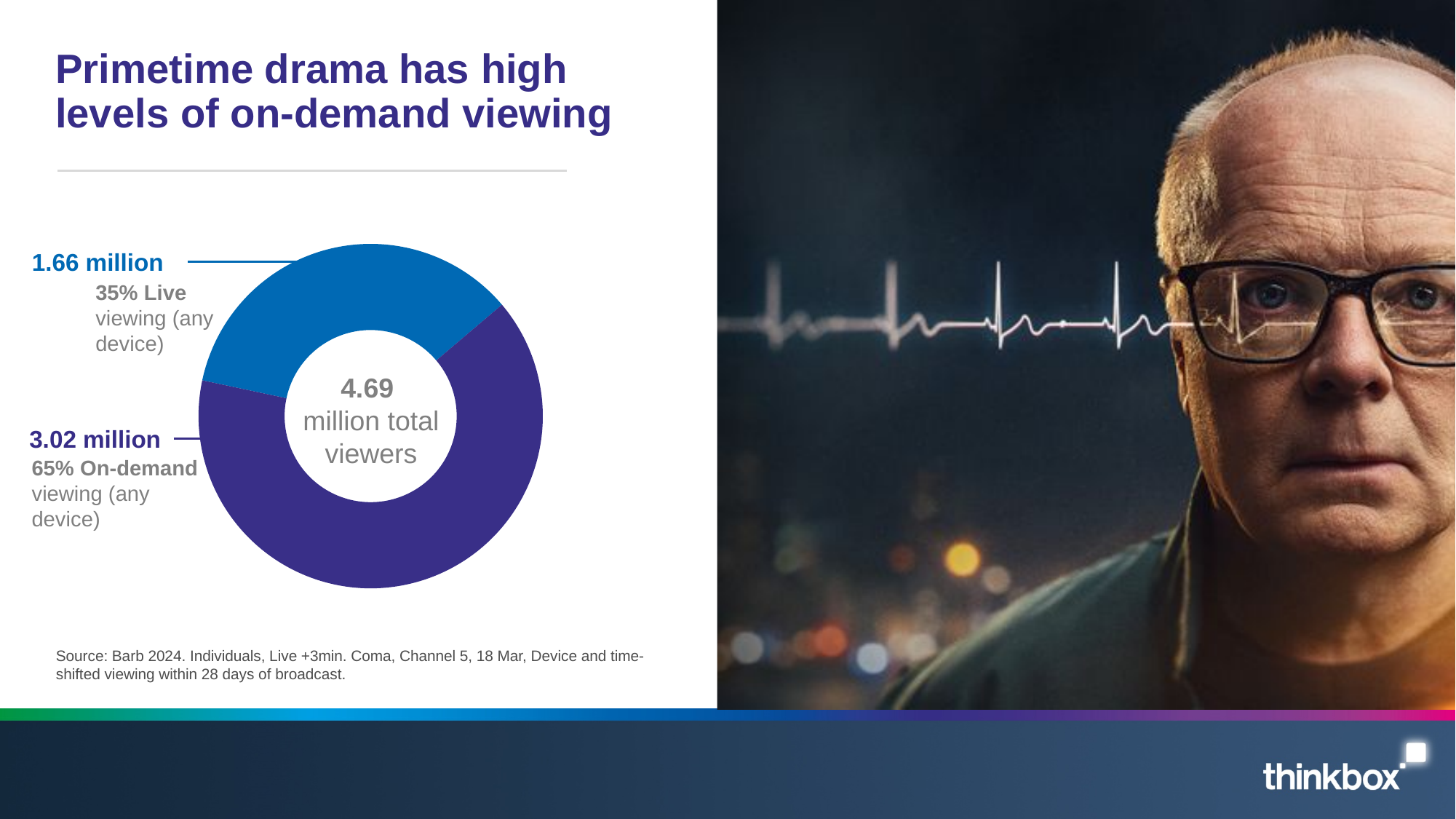
What share of total viewers is Live viewing (any device)? 35% What is the title of the slide? Primetime drama has high levels of on-demand viewing What share of total viewers is On-demand viewing (any device)? 65% How many viewers does the On-demand viewing (any device) segment represent? 3.02 million What colour is the On-demand viewing segment? Purple What is the total number of viewers shown in the centre of the chart? 4.69 million How many segments does the chart have? 2 What is the difference in viewers between On-demand viewing and Live viewing? 1.36 million Which segment is larger, Live viewing or On-demand viewing? On-demand viewing What kind of chart is shown on the slide? Doughnut (pie) chart Which segment has the smallest share of viewers? Live viewing (any device) How many viewers does the Live viewing (any device) segment represent? 1.66 million